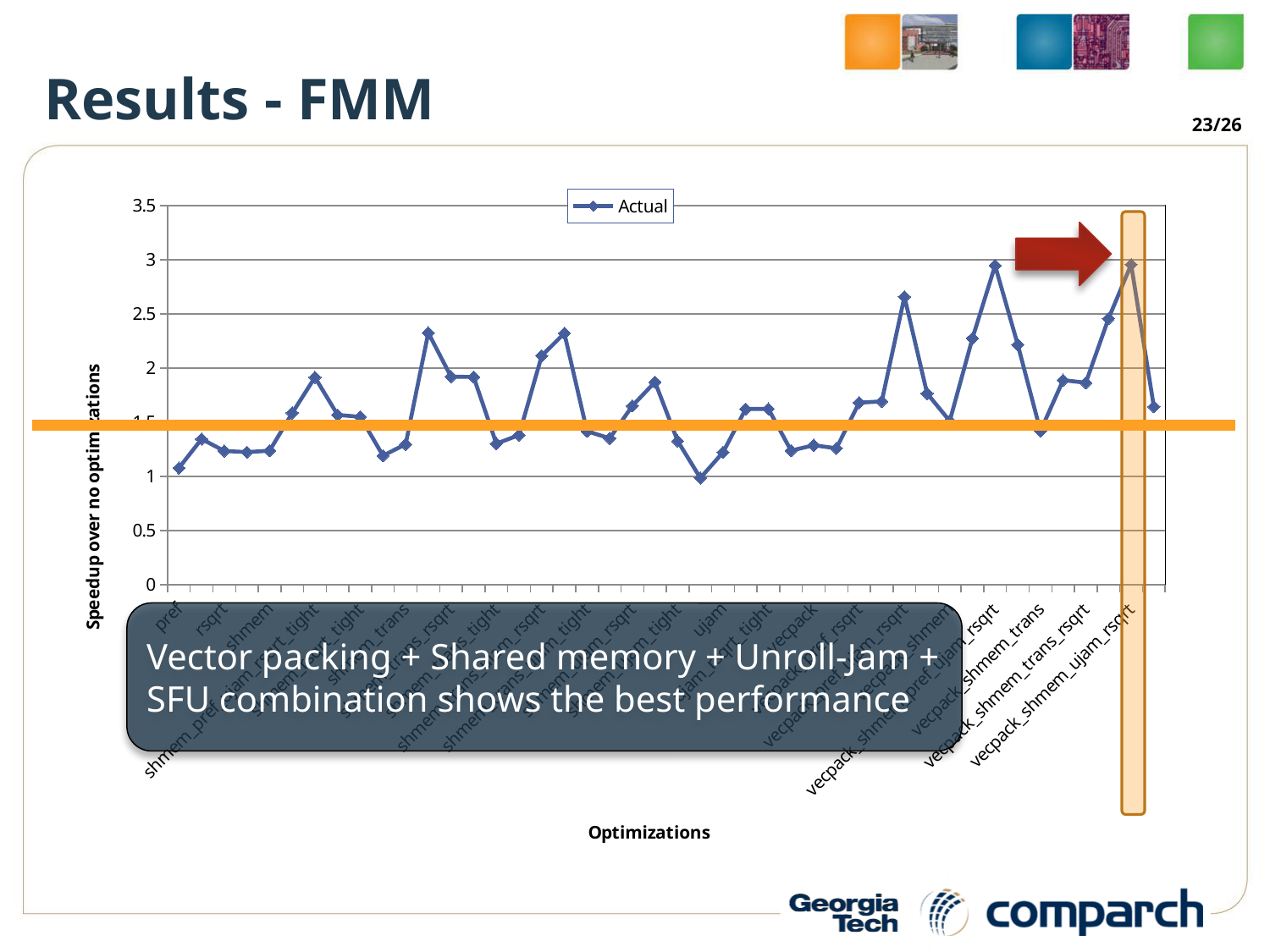
What is the name of the series shown in the legend? Actual Is the value for vecpack_shmem_trans_rsqrt greater or less than 1.5? greater Which has the higher value, vecpack_shmem_ujam_rsqrt or vecpack_shmem_trans? vecpack_shmem_ujam_rsqrt Is the value for vecpack greater or less than 1.5? less What is the title of the y axis? Speedup over no optimizations How many series does the legend list? 1 What kind of chart is shown on the slide? line chart Which has the higher value, vecpack_shmem_trans_rsqrt or ujam? vecpack_shmem_trans_rsqrt Which has the higher value, pref or vecpack_shmem_ujam_rsqrt? vecpack_shmem_ujam_rsqrt Is the value for ujam greater or less than 1.5? less